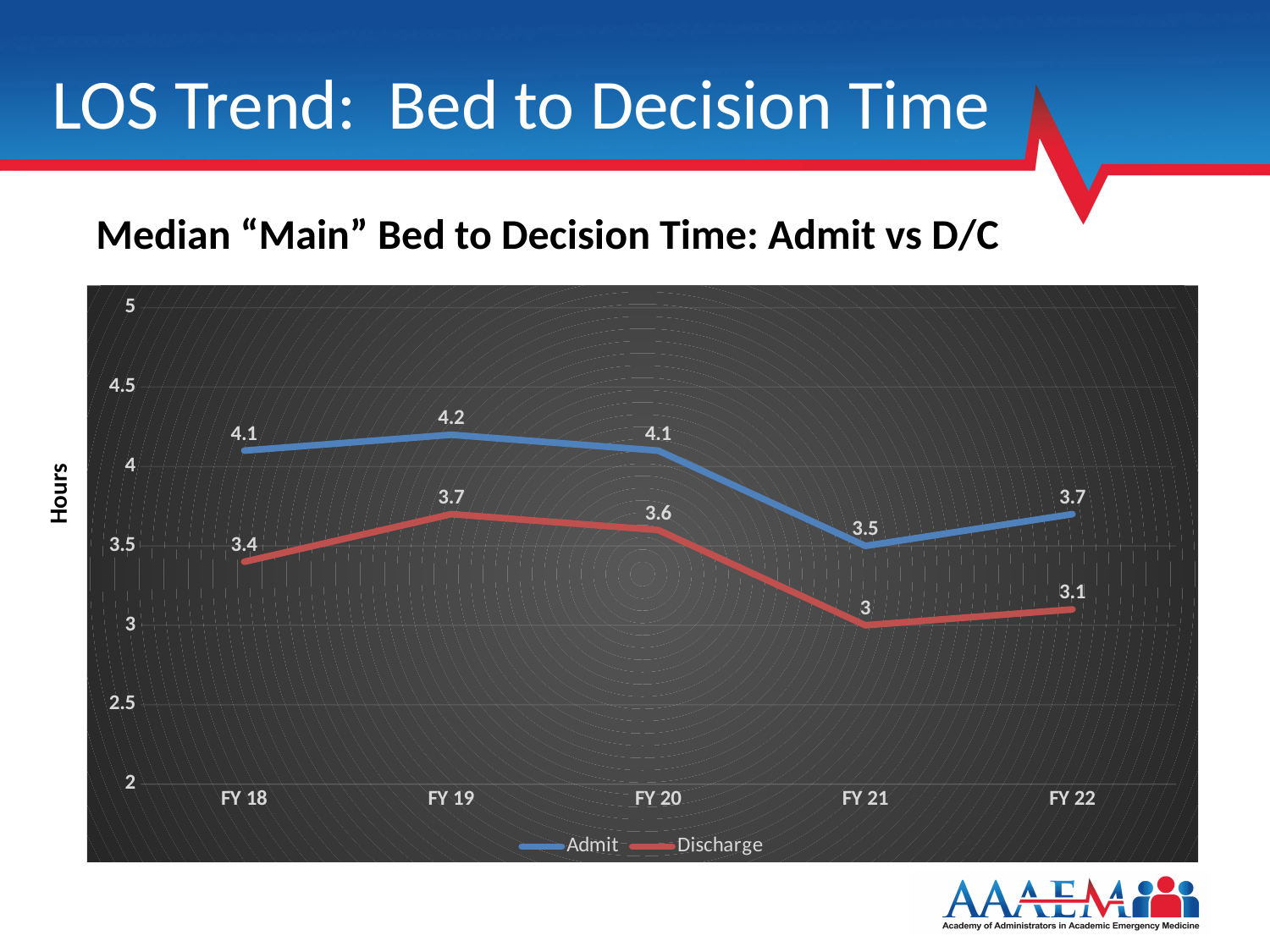
What kind of chart is shown? Line chart In which fiscal year is the Admit value highest? FY 19 What is the difference between the Admit and Discharge values in FY 18? 0.7 Does the Discharge value rise or fall from FY 20 to FY 21? Fall What is the label on the vertical axis? Hours Which is larger in FY 20, the Admit value or the Discharge value? Admit What is the Admit value for FY 22? 3.7 In which fiscal year is the Discharge value lowest? FY 21 How many series does the legend list? 2 What is the Discharge value for FY 21? 3 What is the Admit value for FY 19? 4.2 How many fiscal years are shown on the x axis? 5